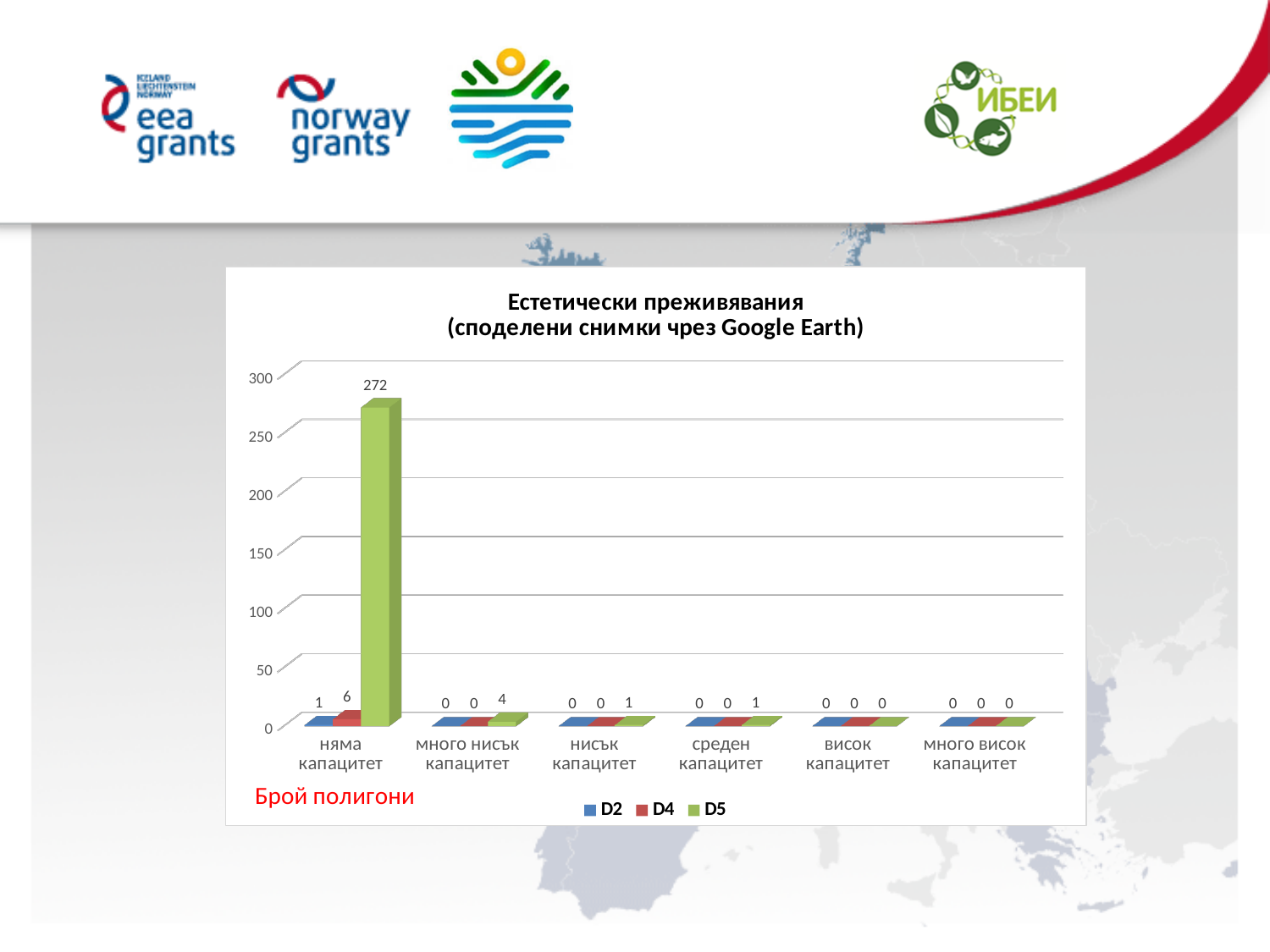
What is the difference between the D5 values for "няма капацитет" and "много нисък капацитет"? 268 What kind of chart is shown on the slide? bar chart Which category has the highest D5 value? няма капацитет What is the value of D5 for "няма капацитет"? 272 What is the value of D4 for "няма капацитет"? 6 How many series does the legend list? 3 How many categories are shown on the x axis? 6 What is the value of D2 for "няма капацитет"? 1 Is the D5 value for "няма капацитет" greater or less than 250? greater Which is larger: D4 for "няма капацитет" or D5 for "много нисък капацитет"? D4 for няма капацитет What is the value of D5 for "много нисък капацитет"? 4 What are the series names listed in the legend? D2, D4, D5